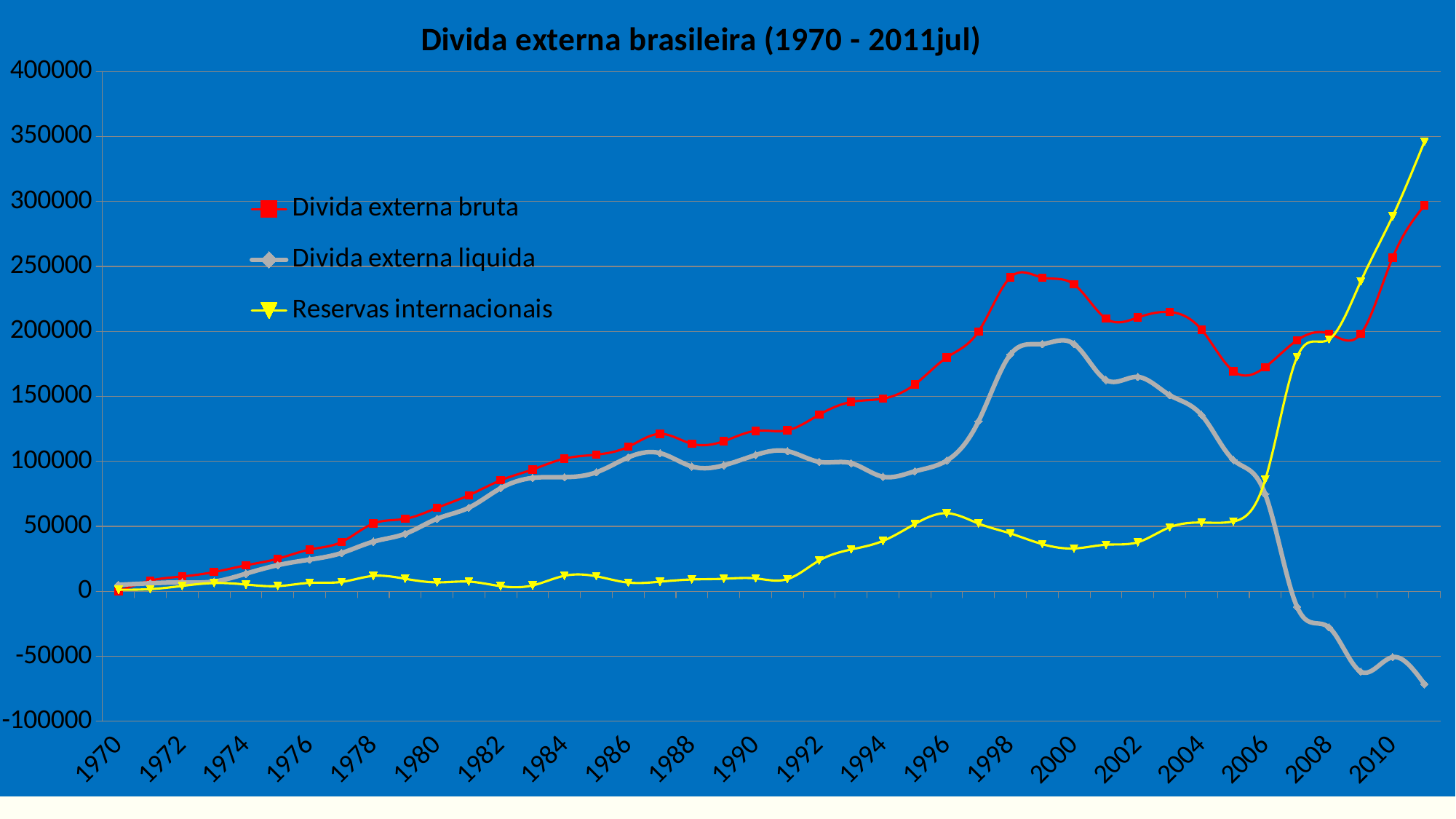
In 1998, which is higher: Divida externa bruta or Reservas internacionais? Divida externa bruta Is the value of Divida externa liquida in 2010 greater or less than 0? less Is the value of Reservas internacionais in 1990 greater or less than 50000? less Is the value of Reservas internacionais in 2010 greater or less than 250000? greater What is the title of the chart? Divida externa brasileira (1970 - 2011jul) Which series is drawn in yellow? Reservas internacionais Which series reaches the lowest value anywhere on the chart? Divida externa liquida What kind of chart is shown on the slide? line chart At the final point of the chart (2011jul), which is higher: Reservas internacionais or Divida externa bruta? Reservas internacionais Does Divida externa liquida rise or fall between 2006 and 2010? fall How many series does the legend list? 3